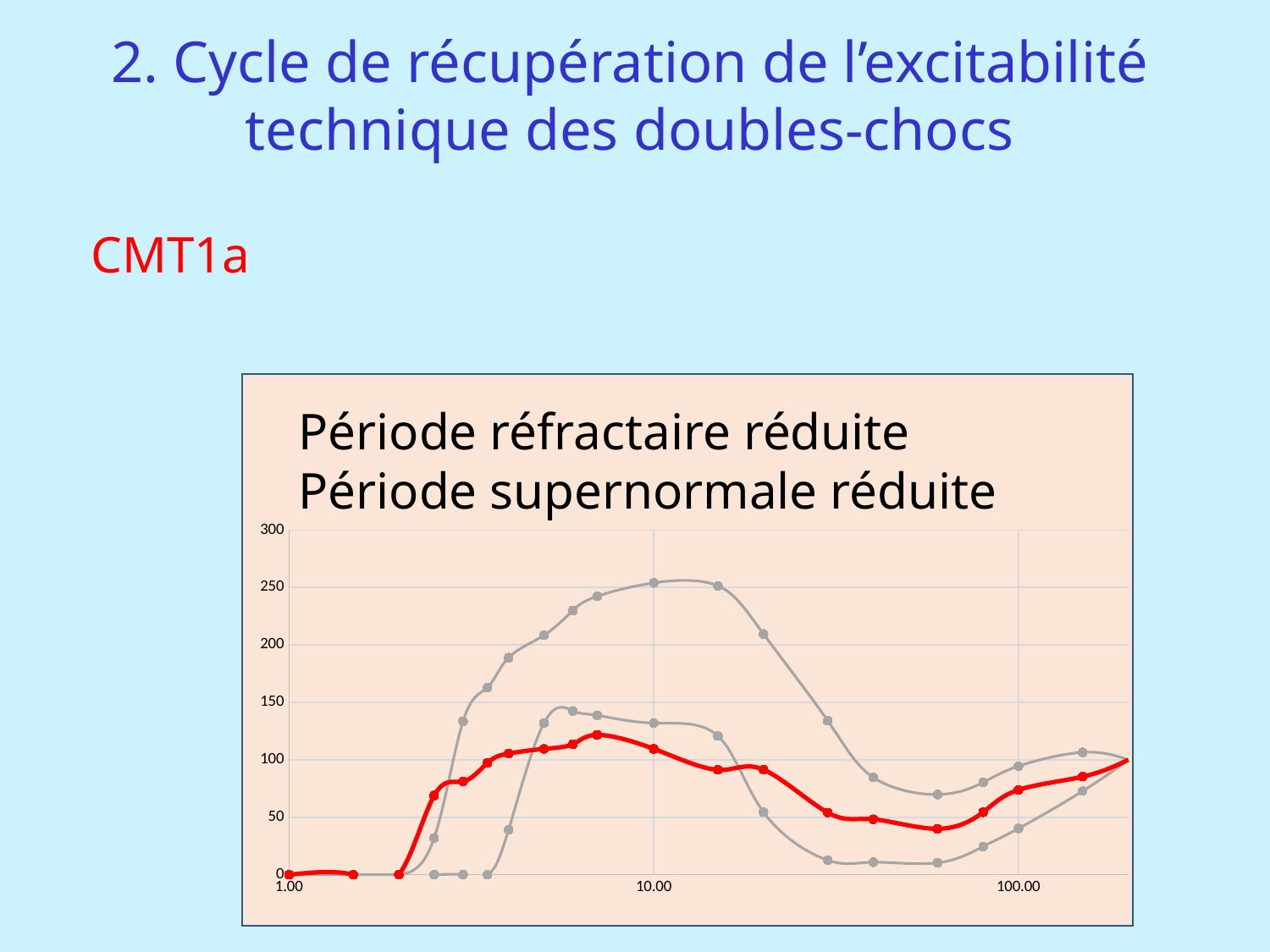
Does the red line rise or fall between x = 10.00 and x = 60? fall Is the value of the lower grey line at around x = 30 greater or less than 50? less Is the value of the lower grey line at x = 10.00 greater or less than 100? greater Is the peak value of the upper grey line (near x = 10.00) greater or less than 200? greater What is the highest value shown on the y axis? 300 What is the value of the red line at x = 1.00? 0 At x = 10.00, which line is higher: the red line or the upper grey line? the upper grey line What kind of chart is shown on the slide? line chart What text is written as the chart's title? Période réfractaire réduite Période supernormale réduite How many lines are plotted on the chart? 3